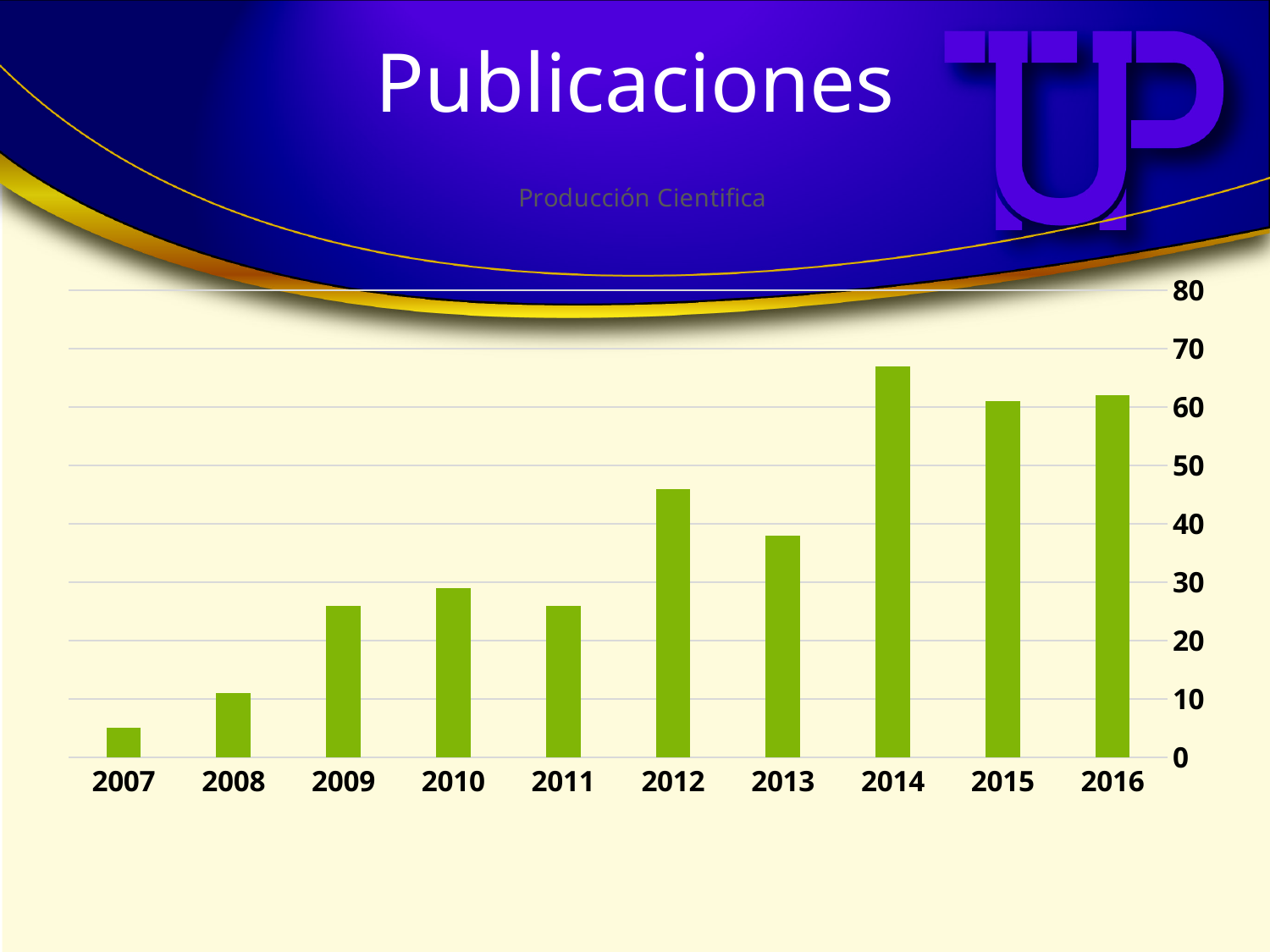
Which year has the highest bar in the chart? 2014 What is the title of the slide containing the chart? Publicaciones Do the values generally rise or fall from 2007 to 2016? rise What kind of chart is shown on the slide? bar chart How many years are shown on the x axis of the chart? 10 Which year has the larger value, 2012 or 2013? 2012 Is the value for 2012 greater or less than 40? greater Which year has the lowest bar in the chart? 2007 Which year has the larger value, 2014 or 2015? 2014 Is the value for 2007 greater or less than 10? less Is the value for 2014 greater or less than 60? greater